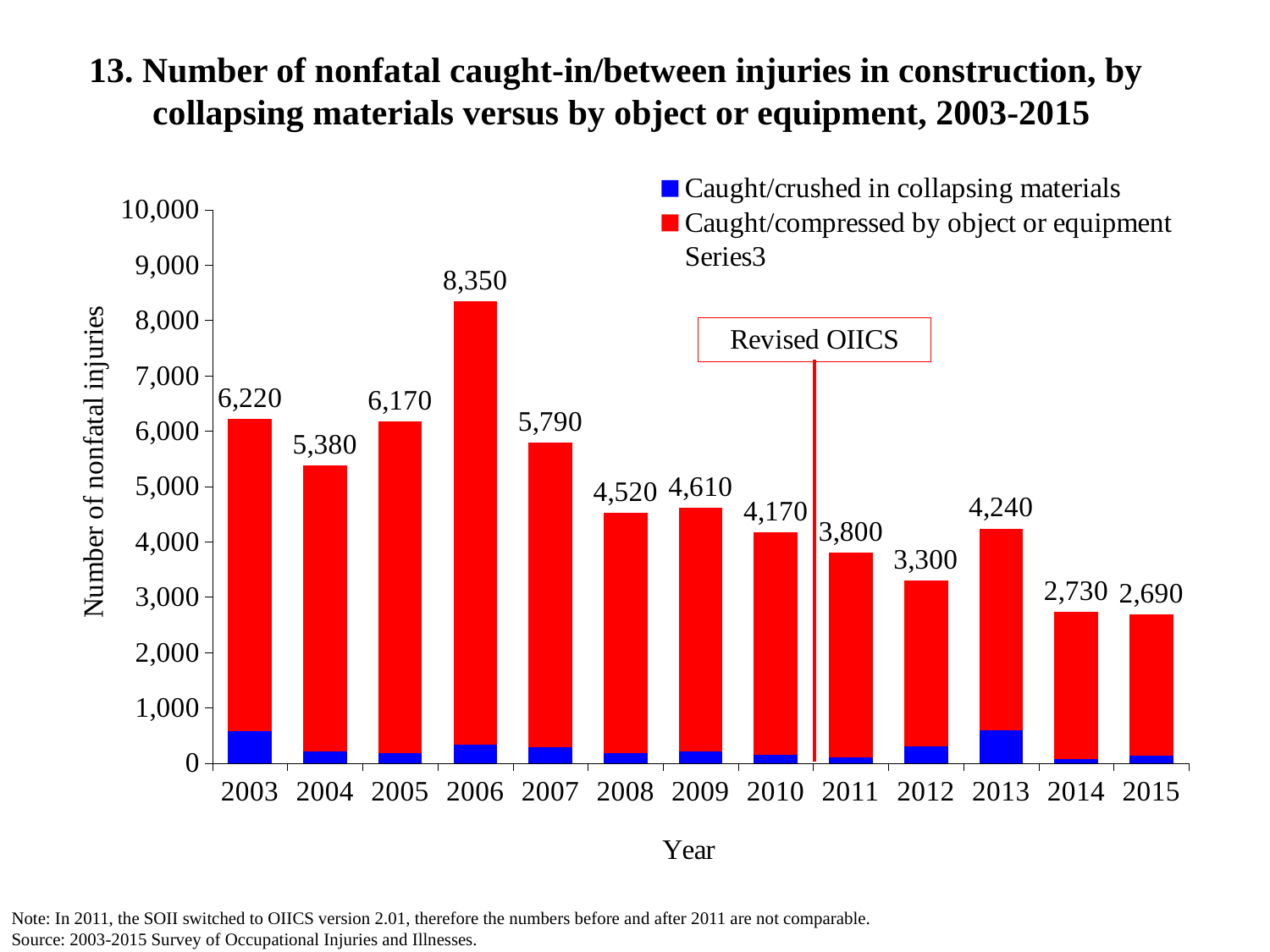
What is the total number of nonfatal caught-in/between injuries shown for 2006? 8,350 What kind of chart is shown on the slide? Stacked bar chart How many entries does the legend list? 3 What is the total number of nonfatal injuries shown for 2011? 3,800 Which year has the highest total number of nonfatal injuries? 2006 What is the total of the stacked bar for 2010? 4,170 Which year has the lowest total number of nonfatal injuries? 2015 Which year has a larger total, 2008 or 2009? 2009 Is the value for 'Caught/crushed in collapsing materials' in 2003 greater or less than 1,000? less How many years are shown on the x axis? 13 What is the difference between the total for 2006 and the total for 2003? 2,130 Do the total values rise or fall from 2006 to 2008? fall